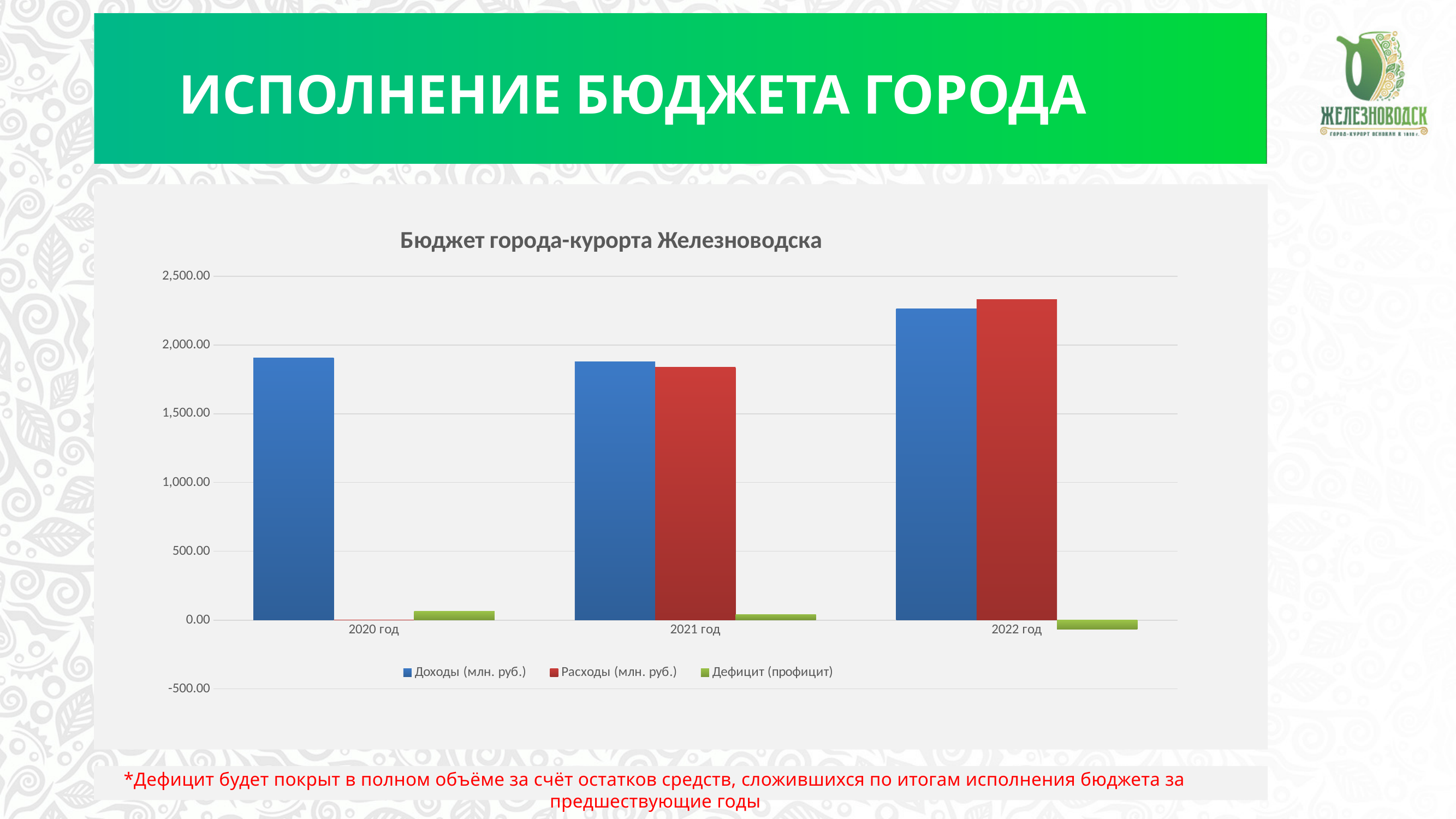
Is the value of Доходы (млн. руб.) for 2020 год greater or less than 2,000.00? less Is the value of Дефицит (профицит) for 2022 год greater or less than 0.00? less What is the title of the chart? Бюджет города-курорта Железноводска How many series does the legend list? 3 How many years are shown on the x axis? 3 Do the values of Расходы (млн. руб.) rise or fall from 2020 год to 2022 год? rise What kind of chart is shown on the slide? bar chart Which series is shown in green in the legend? Дефицит (профицит) In 2022 год, which is larger: Доходы (млн. руб.) or Расходы (млн. руб.)? Расходы (млн. руб.) In which year is Расходы (млн. руб.) the highest? 2022 год Is the value of Доходы (млн. руб.) for 2022 год greater or less than 2,000.00? greater